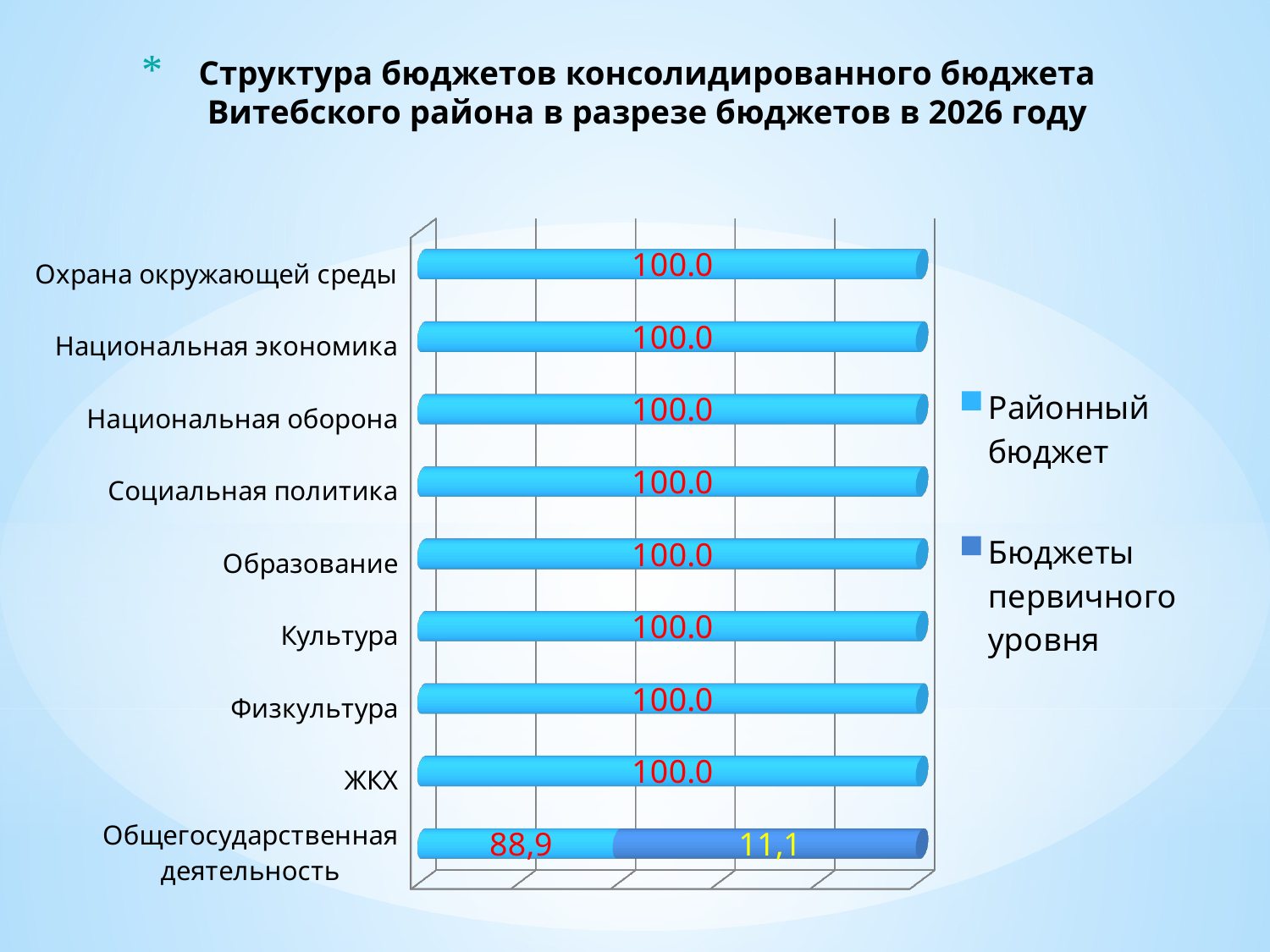
What is the value of Районный бюджет for Образование? 100.0 How many series does the legend list? 2 What is the value of Районный бюджет for Общегосударственная деятельность? 88,9 What is the total of the stacked bar for Общегосударственная деятельность? 100 How many categories are shown on the chart? 9 What is the value of Бюджеты первичного уровня for Общегосударственная деятельность? 11,1 What is the difference between the Районный бюджет and Бюджеты первичного уровня values for Общегосударственная деятельность? 77,8 Which is larger for Общегосударственная деятельность: Районный бюджет or Бюджеты первичного уровня? Районный бюджет What are the two series listed in the legend? Районный бюджет; Бюджеты первичного уровня What is the value of Районный бюджет for ЖКХ? 100.0 Which category has the lowest value for Районный бюджет? Общегосударственная деятельность What kind of chart is shown on the slide? bar chart